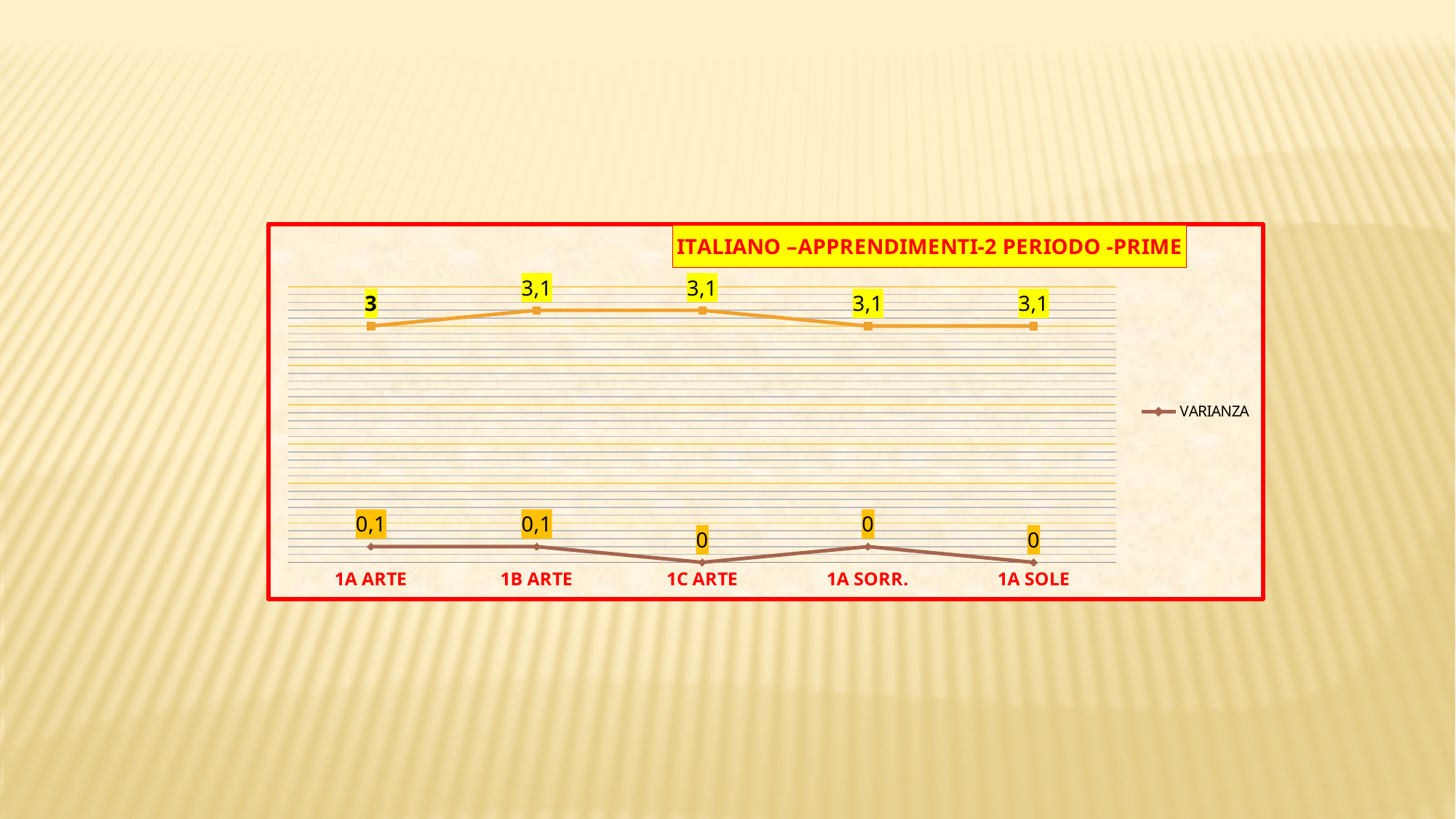
What is the VARIANZA value for 1C ARTE? 0 How many series does the chart's legend list? 1 What is the value of the upper orange line for 1A SORR.? 3,1 How many categories are shown on the x axis of the chart? 5 What is the difference between the upper orange line value for 1B ARTE and for 1A ARTE? 0,1 What is the VARIANZA value for 1A ARTE? 0,1 What kind of chart is shown on the slide? line chart What is the value of the upper orange line for 1A ARTE? 3 Which is larger, the VARIANZA value for 1B ARTE or for 1C ARTE? 1B ARTE What is the VARIANZA value for 1A SOLE? 0 What is the title of the chart? ITALIANO –APPRENDIMENTI-2 PERIODO -PRIME